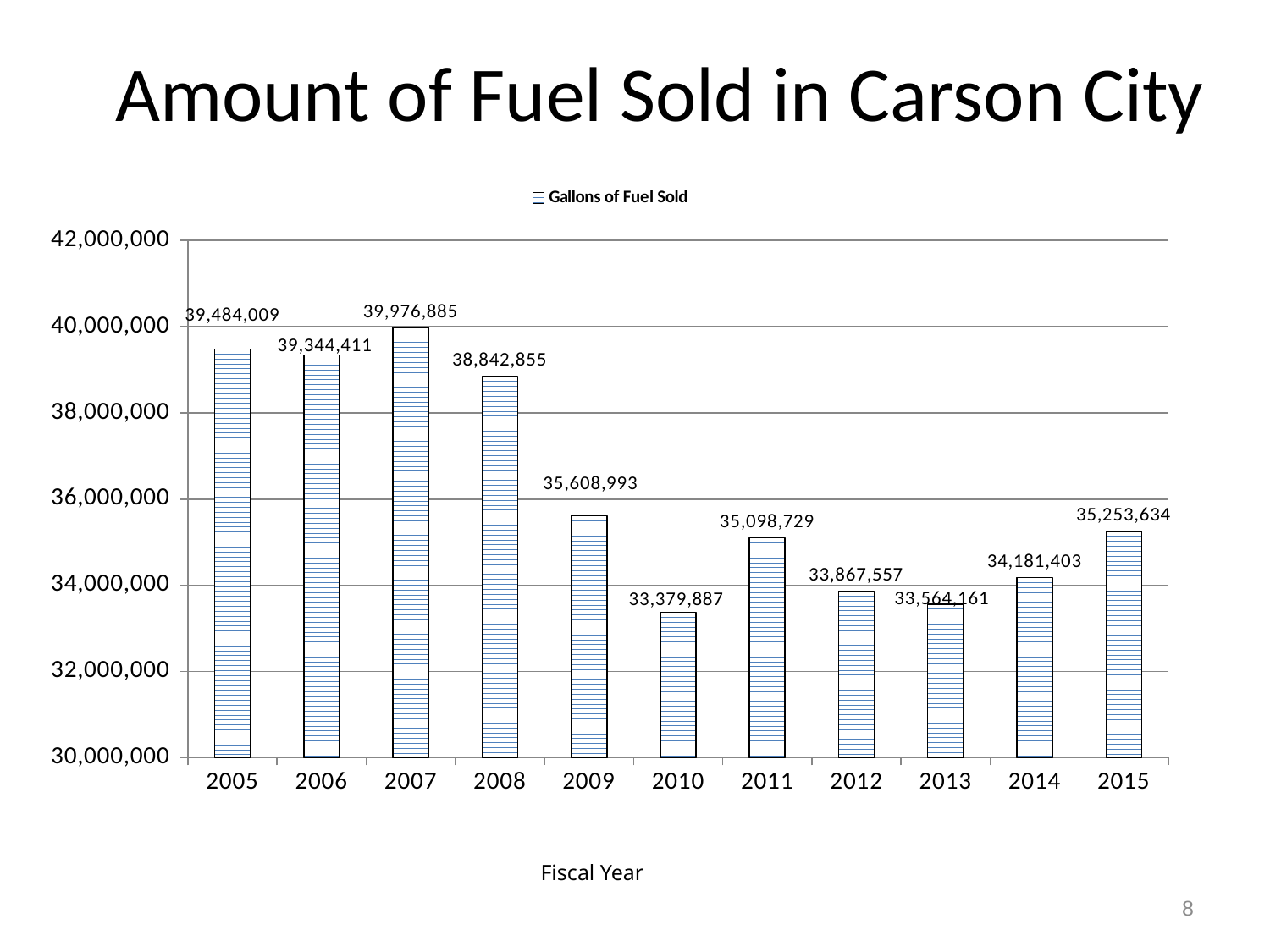
Which fiscal year has the lowest amount of fuel sold? 2010 Which is larger, the value for 2005 or the value for 2006? 2005 What is the value for 2007? 39,976,885 What kind of chart is shown on the slide? bar chart Which fiscal year has the highest amount of fuel sold? 2007 What is the difference between the values for 2015 and 2014? 1,072,231 What is the label of the x axis? Fiscal Year What is the value shown for 2015? 35,253,634 How many gallons of fuel were sold in fiscal year 2010? 33,379,887 What is the difference between the values for 2007 and 2010? 6,596,998 How many fiscal years are shown on the x axis? 11 Is the value for 2012 greater or less than 34,000,000? less